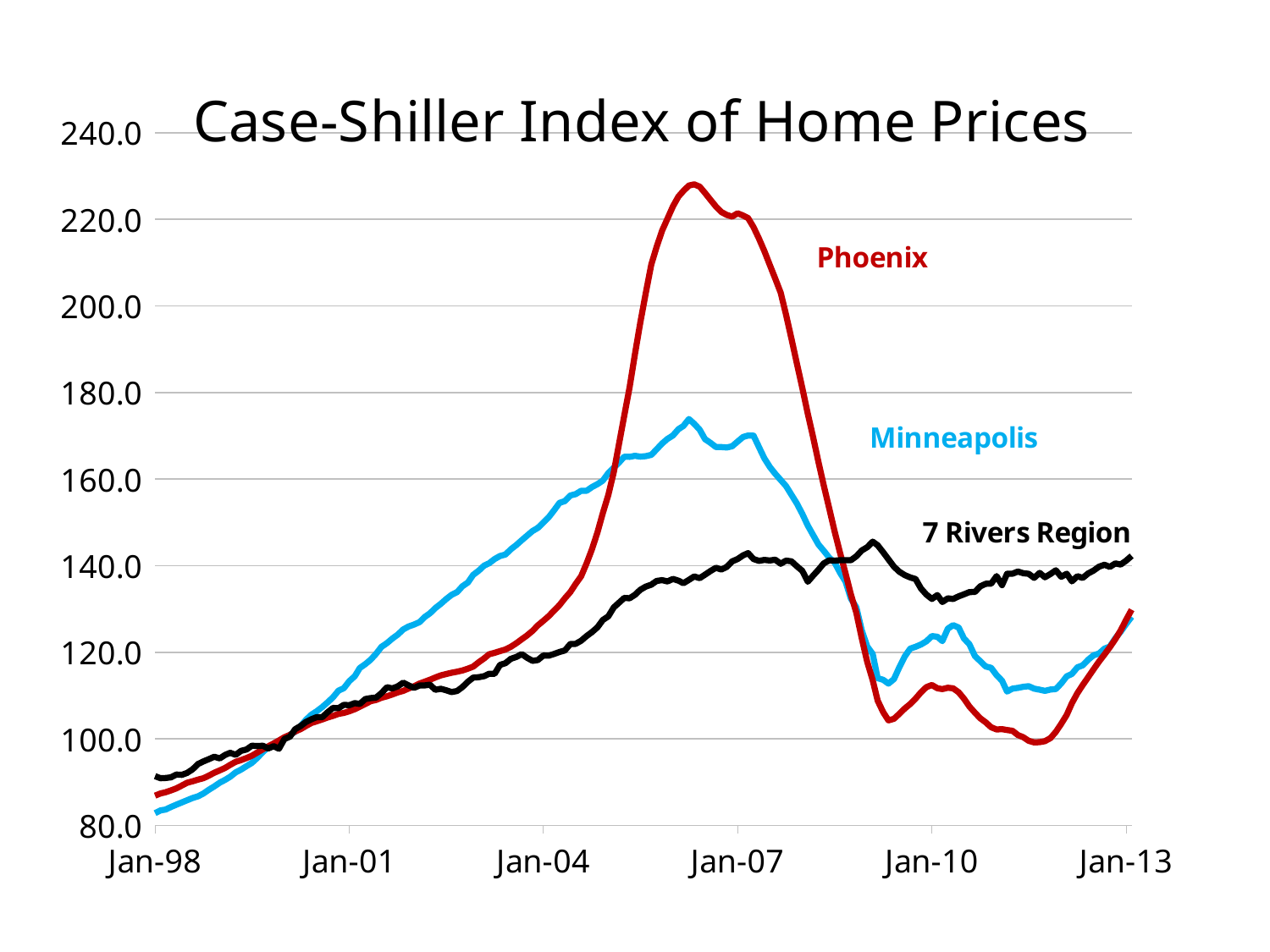
At Jan-10, which is higher: 7 Rivers Region or Phoenix? 7 Rivers Region Is the value for Phoenix at Jan-10 greater or less than 120? less Which series is drawn in red? Phoenix Is the peak value for Phoenix greater or less than 220? greater How many series are plotted on the chart? 3 Is the value for Minneapolis at Jan-98 greater or less than 100? less What is the title of the chart? Case-Shiller Index of Home Prices Does the Phoenix line rise or fall between Jan-07 and Jan-10? fall At Jan-07, which is higher: Phoenix or 7 Rivers Region? Phoenix What kind of chart is shown on the slide? line chart Which series reaches the highest peak on the chart? Phoenix